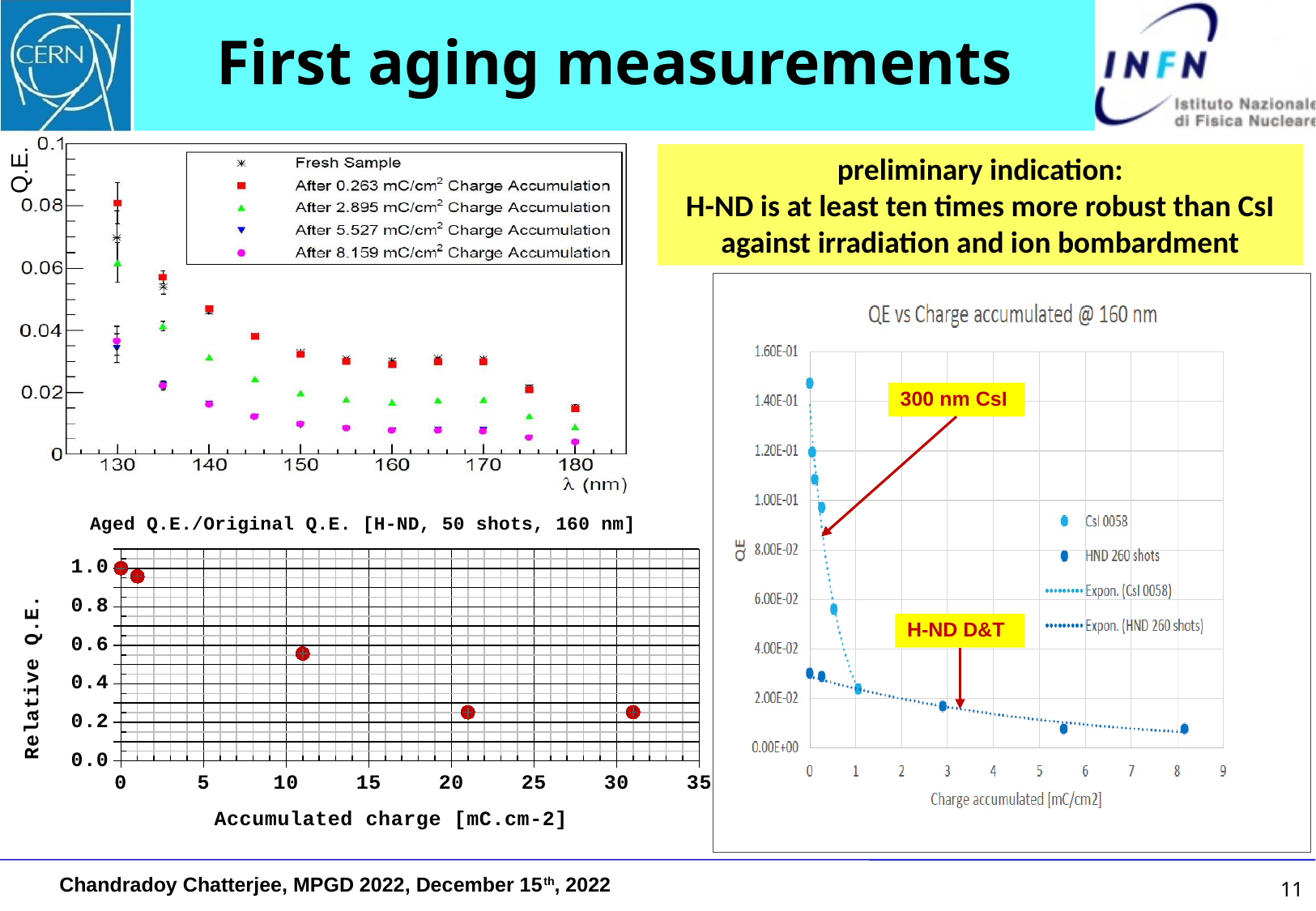
On the chart titled 'QE vs Charge accumulated @ 160 nm', is the first CsI 0058 point (at zero charge) greater or less than 1.20E-01? greater On the chart titled 'Aged Q.E./Original Q.E. [H-ND, 50 shots, 160 nm]', do the values rise or fall as accumulated charge increases? fall On the chart titled 'QE vs Charge accumulated @ 160 nm', what is the label of the x axis? Charge accumulated [mC/cm2] On the chart titled 'QE vs Charge accumulated @ 160 nm', how many entries does the legend list? 4 On the chart titled 'Aged Q.E./Original Q.E. [H-ND, 50 shots, 160 nm]', how many data points are plotted? 5 On the chart titled 'QE vs Charge accumulated @ 160 nm', is the first HND 260 shots point (at zero charge) greater or less than 4.00E-02? less On the top-left Q.E. versus wavelength chart, is the Fresh Sample value at 130 nm greater or less than 0.06? greater What kind of chart is the one titled 'Aged Q.E./Original Q.E. [H-ND, 50 shots, 160 nm]'? scatter chart On the top-left Q.E. versus wavelength chart, at 130 nm which is larger: the value after 0.263 mC/cm² charge accumulation or the value after 8.159 mC/cm² charge accumulation? After 0.263 mC/cm² Charge Accumulation On the chart titled 'QE vs Charge accumulated @ 160 nm', which series has the higher QE at zero accumulated charge, CsI 0058 or HND 260 shots? CsI 0058 On the top-left Q.E. versus wavelength chart, how many series does the legend list? 5